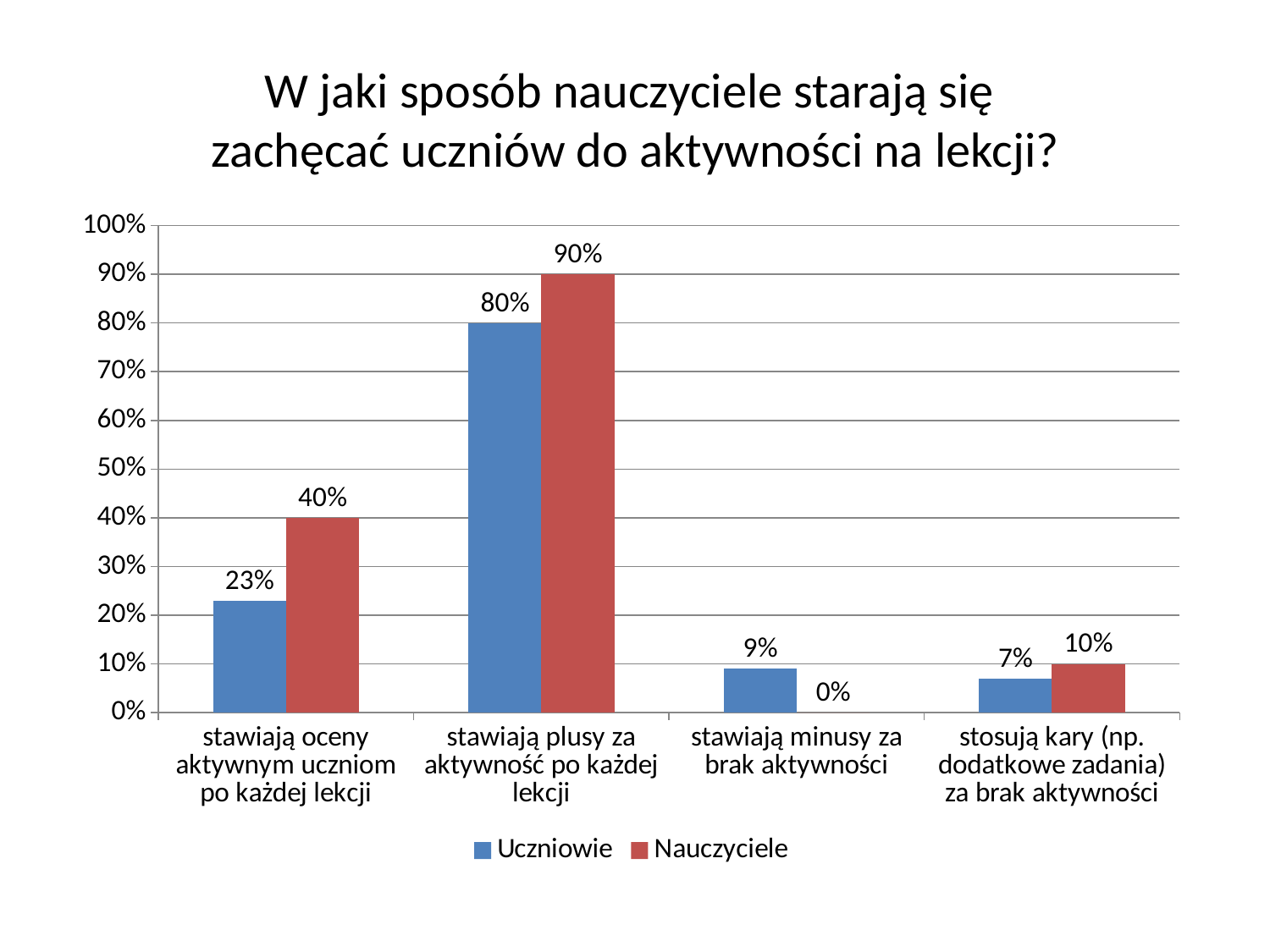
How many categories are shown on the x axis? 4 What is the difference between the Nauczyciele and Uczniowie values in the category "stawiają oceny aktywnym uczniom po każdej lekcji"? 17% Is the value for Uczniowie in the category "stawiają plusy za aktywność po każdej lekcji" greater or less than 50%? greater How many series does the legend list? 2 Which category has the lowest value for Nauczyciele? stawiają minusy za brak aktywności In the category "stosują kary (np. dodatkowe zadania) za brak aktywności", which series has the larger value, Uczniowie or Nauczyciele? Nauczyciele What is the value for Nauczyciele in the category "stawiają minusy za brak aktywności"? 0% Which colour represents the Nauczyciele series? red Which category has the highest value for Uczniowie? stawiają plusy za aktywność po każdej lekcji What is the value for Nauczyciele in the category "stawiają plusy za aktywność po każdej lekcji"? 90% What is the value for Uczniowie in the category "stawiają oceny aktywnym uczniom po każdej lekcji"? 23% What kind of chart is shown on the slide? bar chart